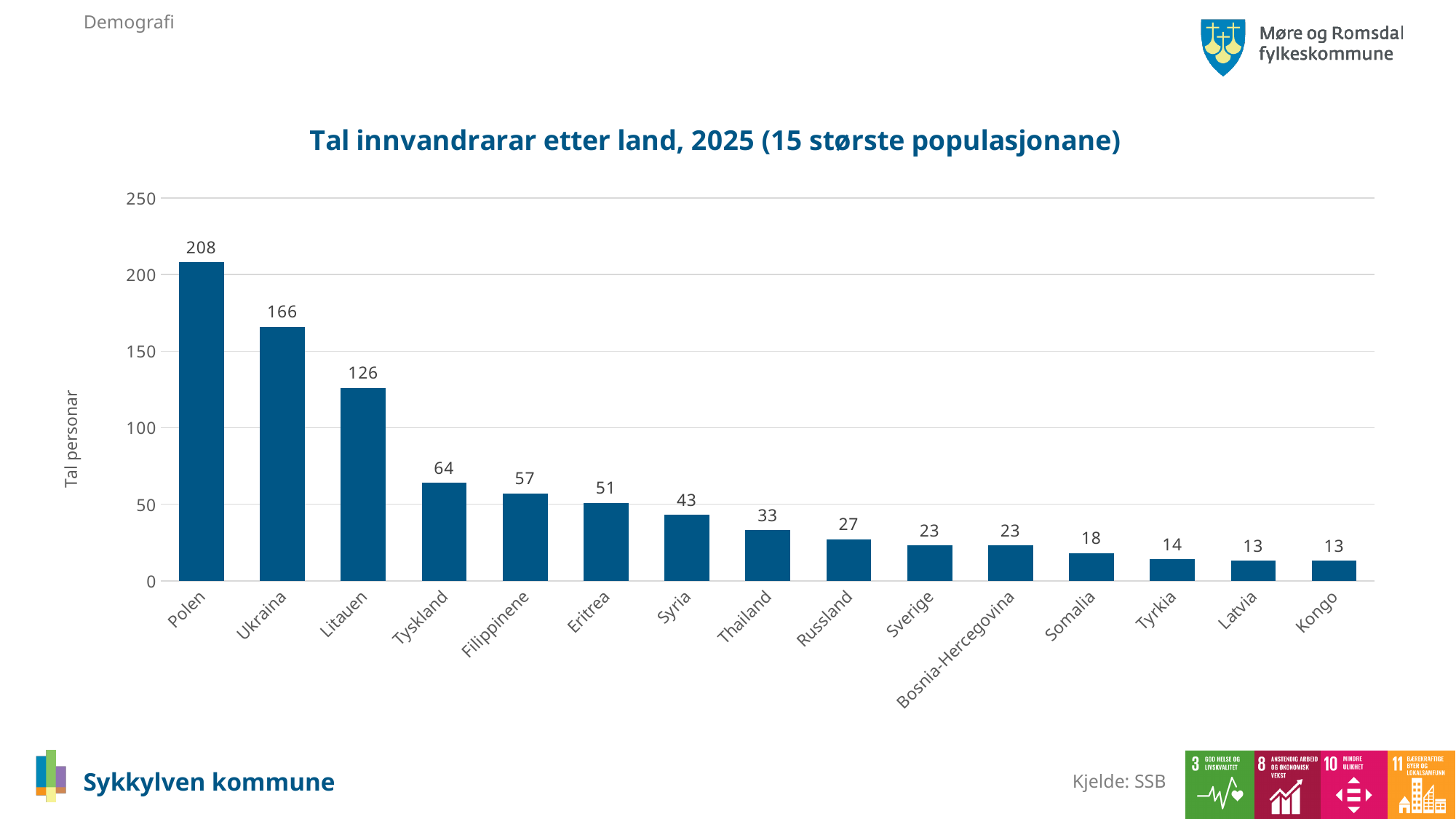
Is the value for Syria greater or less than 50? less Do the values rise or fall from left to right along the x axis? fall What is the difference between the values for Ukraina and Litauen? 40 Which country has the highest value? Polen Which is larger, the value for Filippinene or the value for Eritrea? Filippinene How many countries are shown on the chart? 15 What is the value for Polen? 208 What is the value for Tyskland? 64 What is the title of the chart? Tal innvandrarar etter land, 2025 (15 største populasjonane) What is the value for Somalia? 18 What is the label of the y axis? Tal personar What kind of chart is shown on the slide? bar chart